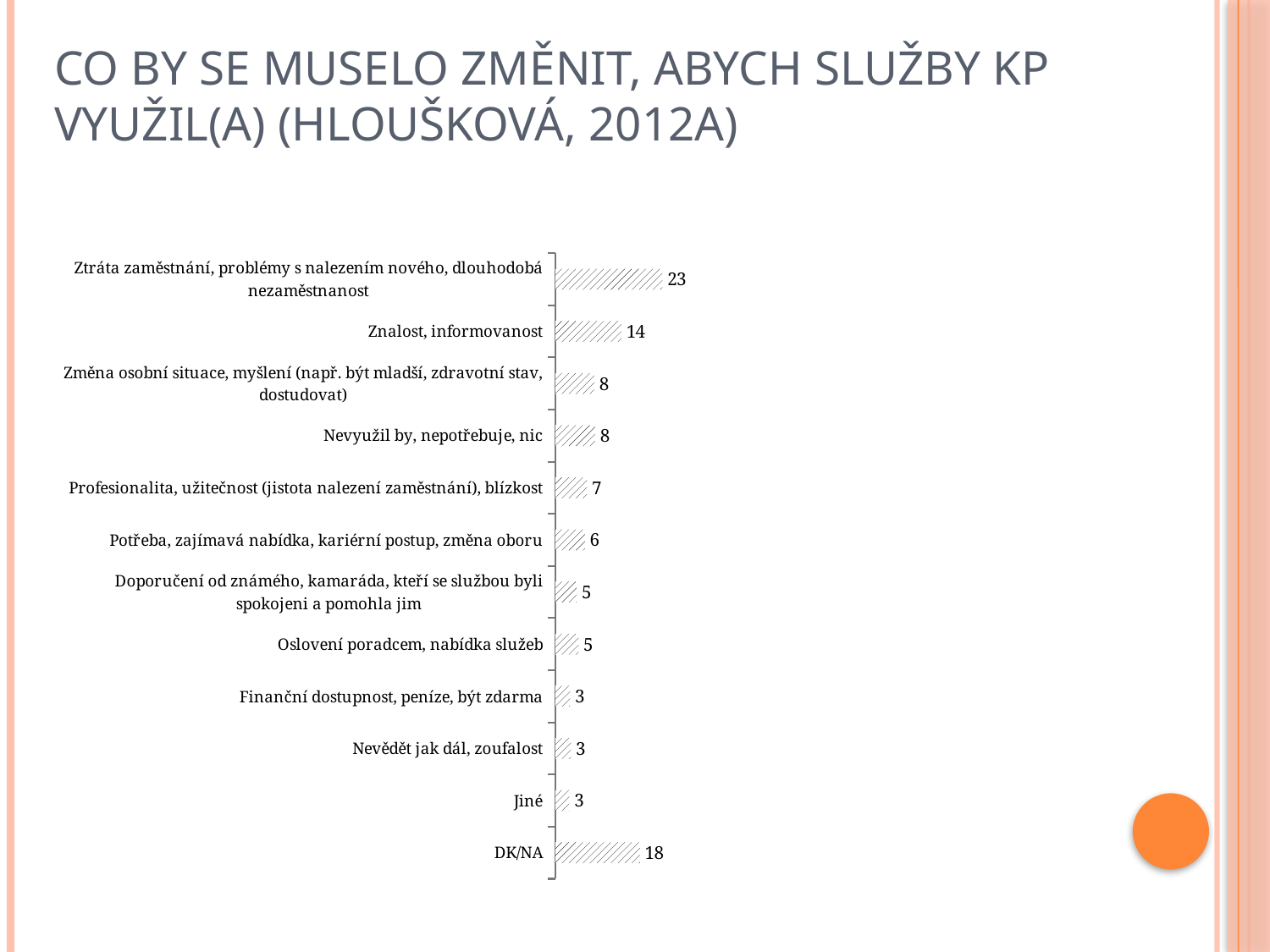
What is the difference between the values for "DK/NA" and "Jiné"? 15 How many categories have a value of 3? 3 What is the value for "DK/NA"? 18 What is the value for "Oslovení poradcem, nabídka služeb"? 5 What is the value for "Znalost, informovanost"? 14 What kind of chart is shown on the slide? Bar chart What is the difference between the values for "Ztráta zaměstnání, problémy s nalezením nového, dlouhodobá nezaměstnanost" and "Znalost, informovanost"? 9 Which is larger, the value for "Profesionalita, užitečnost (jistota nalezení zaměstnání), blízkost" or the value for "Potřeba, zajímavá nabídka, kariérní postup, změna oboru"? Profesionalita, užitečnost (jistota nalezení zaměstnání), blízkost What is the value for "Finanční dostupnost, peníze, být zdarma"? 3 How many categories are shown in the chart? 12 What is the value for "Nevyužil by, nepotřebuje, nic"? 8 Which category has the highest value? Ztráta zaměstnání, problémy s nalezením nového, dlouhodobá nezaměstnanost